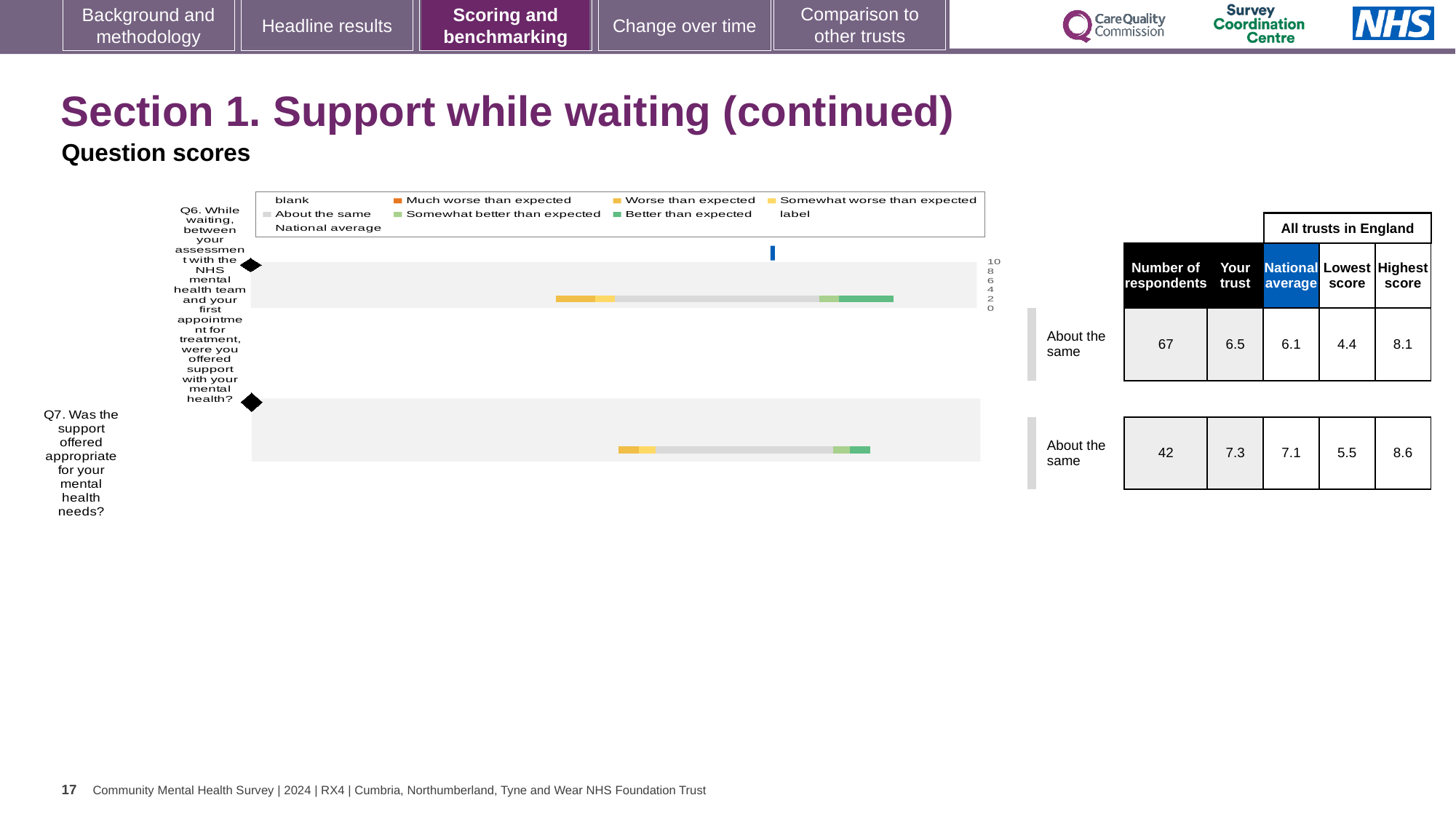
What is the difference between the highest and lowest scores across all trusts in England for Q6? 3.7 By how much does the trust's score for Q7 exceed the national average for Q7? 0.2 Which question has the higher 'Your trust' score, Q6 or Q7? Q7 What is the 'Your trust' score for Q6 (support while waiting between assessment and first appointment)? 6.5 How many questions (categories) are plotted in the chart? 2 Which question has the higher 'Highest score' across all trusts in England? Q7 What benchmark category is shown for both Q6 and Q7? About the same How many respondents answered Q6? 67 How many entries does the chart legend list? 9 What kind of chart is shown on the slide? bar chart What is the lowest score across all trusts in England for Q7? 5.5 What is the national average score for Q7 (was the support offered appropriate for your mental health needs)? 7.1